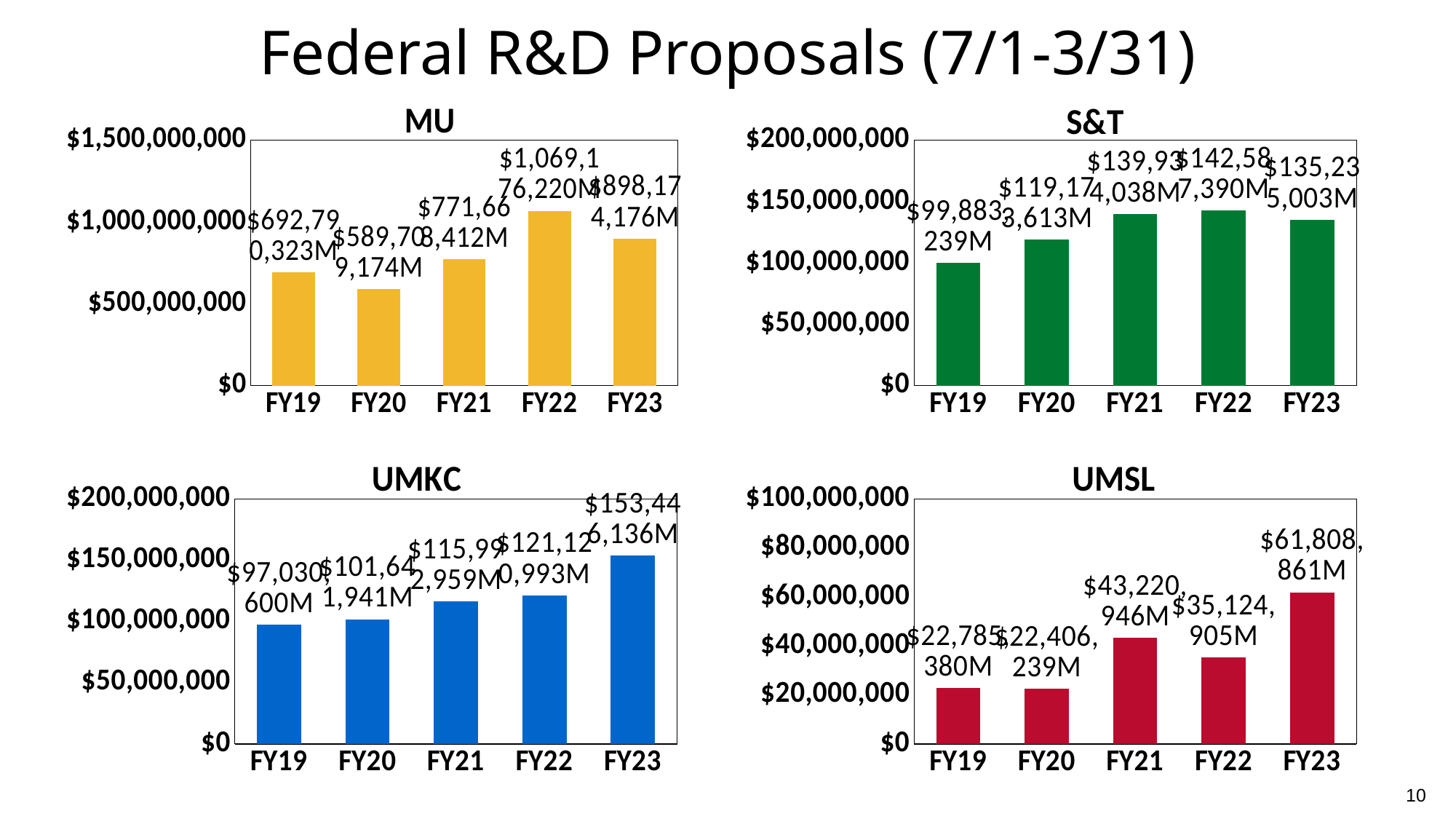
In the UMKC chart, is the value for FY23 greater or less than $150,000,000? greater In the UMKC chart, do the values rise or fall from FY19 to FY23? rise In the UMSL chart, what is the value for FY21? $43,220,946M In the MU chart, which fiscal year has the highest value? FY22 In the UMSL chart, which fiscal year has the highest value? FY23 In the MU chart, which fiscal year has the lowest value? FY20 In the UMSL chart, what is the difference between the FY23 and FY22 values? $26,683,956M In the MU chart, is the value for FY22 greater or less than $1,000,000,000? greater In the UMSL chart, what is the value for FY23? $61,808,861M How many fiscal years are plotted in the UMSL chart? 5 What kind of chart is the MU chart? bar chart In the S&T chart, which fiscal year has the lowest value? FY19